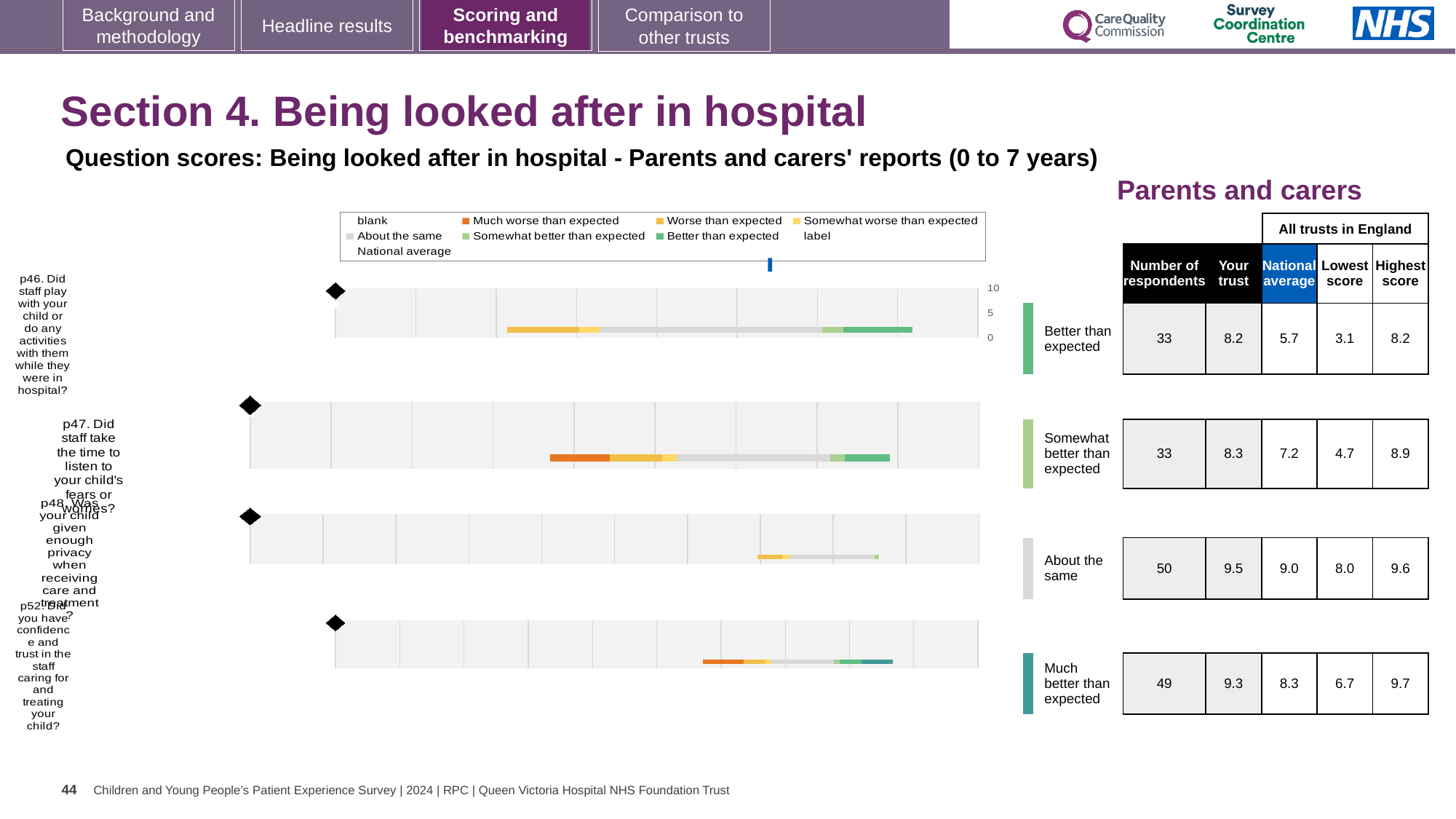
Which colour does the legend use for 'Much worse than expected'? orange What is the highest tick value shown on the axis of the p46 chart? 10 In the table, what is the 'Your trust' score for the 'Better than expected' row? 8.2 Which of the four question charts has the shortest coloured bar? p48 How many entries does the chart legend list? 9 What kind of chart is used to show the question scores on this slide? bar chart In the table, is the 'Your trust' score for 'Much better than expected' larger or smaller than its National average? larger In the table, which row has the highest 'Your trust' score? About the same How many separate question bar charts are shown on the slide? 4 In the table, what is the difference between the Highest score and Lowest score for the 'Somewhat better than expected' row? 4.2 In the table, what is the National average for the 'About the same' row? 9.0 In the table, how many respondents are listed for the 'Much better than expected' row? 49